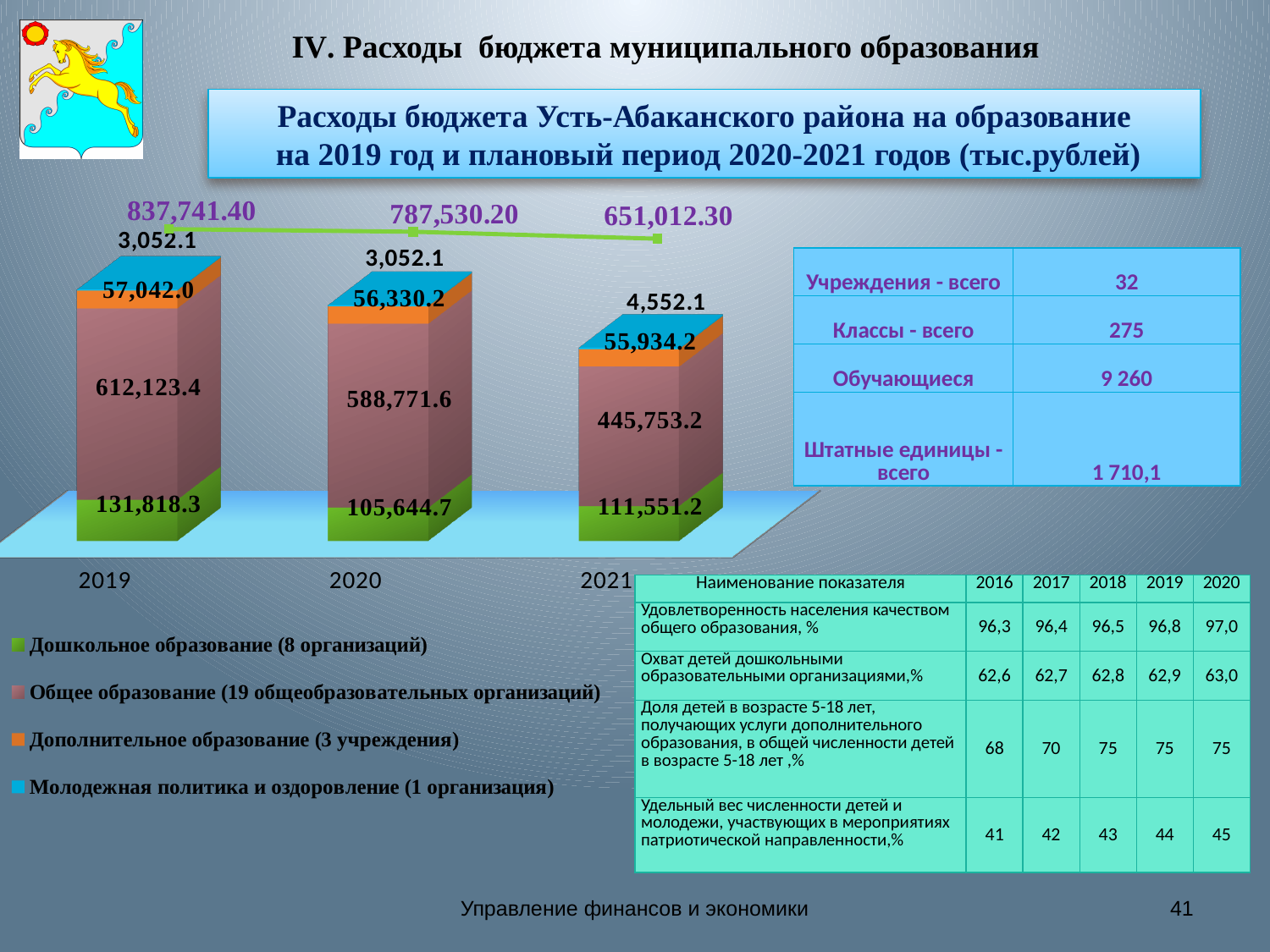
What is the value for Общее образование in 2019? 612,123.4 Does the value for Общее образование rise or fall from 2019 to 2021? fall What total value is labelled on the line above the 2019 bar? 837,741.40 In which year is the value for Дошкольное образование the lowest? 2020 How many years are shown on the x axis of the chart? 3 What is the difference between the Общее образование values for 2019 and 2020? 23,351.8 In which year is the value for Общее образование the highest? 2019 What is the value for Дополнительное образование in 2021? 55,934.2 How many series does the chart legend list? 4 What is the value for Молодежная политика и оздоровление in 2021? 4,552.1 What is the value for Дошкольное образование in 2020? 105,644.7 Which is larger: Дошкольное образование in 2019 or in 2021? 2019